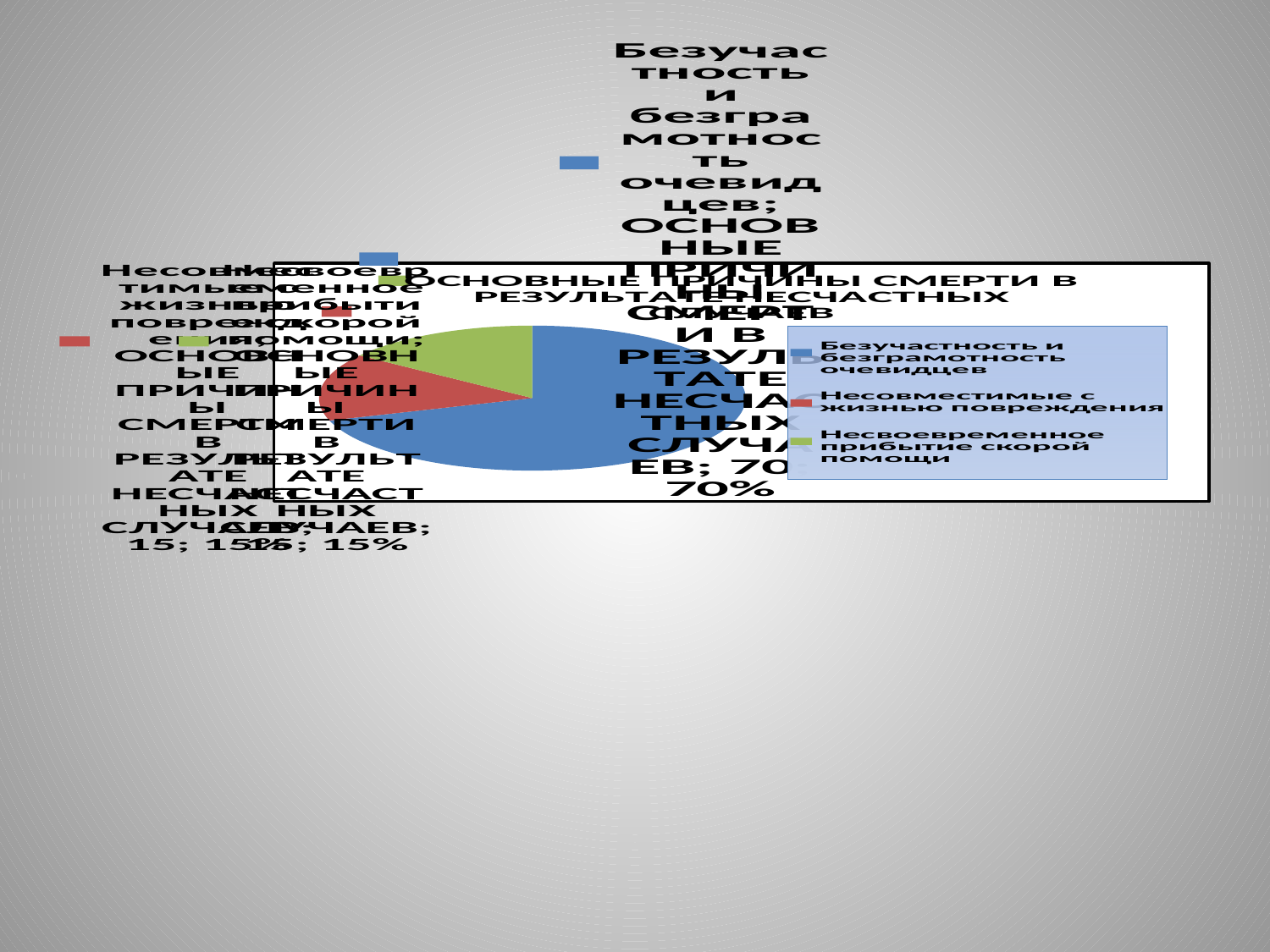
What share of the pie does 'Безучастность и безграмотность очевидцев' take? 70% What kind of chart is shown on the slide? pie chart What is the data value shown for 'Безучастность и безграмотность очевидцев'? 70 What share of the pie does 'Несовместимые с жизнью повреждения' take? 15% What is the difference in percentage points between the 'Безучастность и безграмотность очевидцев' slice and the 'Несвоевременное прибытие скорой помощи' slice? 55 Which category has the largest slice of the pie? Безучастность и безграмотность очевидцев Which is larger: the slice for 'Безучастность и безграмотность очевидцев' or the slice for 'Несовместимые с жизнью повреждения'? Безучастность и безграмотность очевидцев How many entries does the legend list? 3 What share of the pie does 'Несвоевременное прибытие скорой помощи' take? 15% What colour is the slice for 'Несвоевременное прибытие скорой помощи'? green How many slices does the pie chart have? 3 What is the title of the chart? ОСНОВНЫЕ ПРИЧИНЫ СМЕРТИ В РЕЗУЛЬТАТЕ НЕСЧАСТНЫХ СЛУЧАЕВ